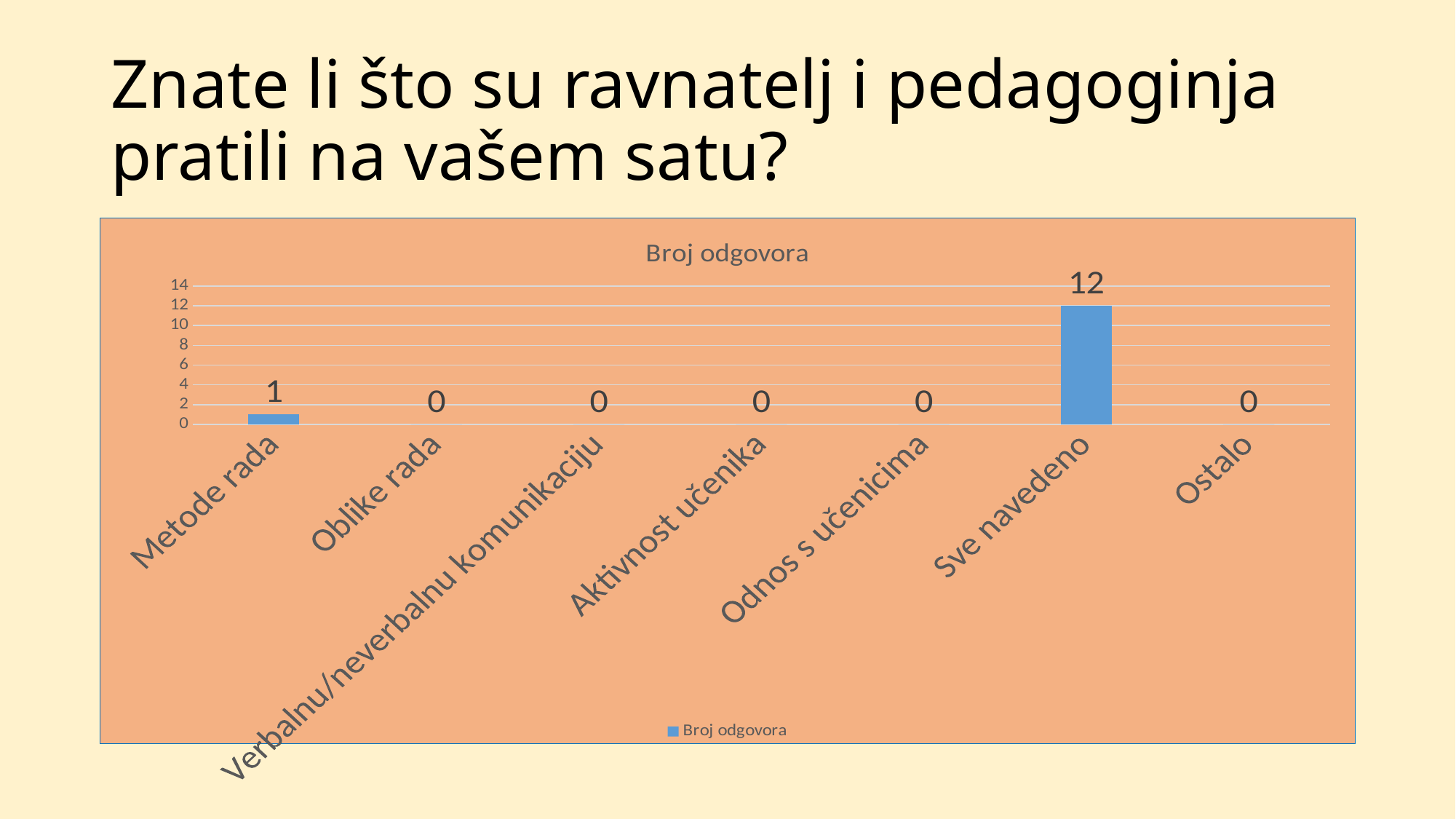
What is the value for 'Metode rada'? 1 Which is larger, the value for 'Metode rada' or the value for 'Aktivnost učenika'? Metode rada What kind of chart is shown? bar chart What is the value for 'Sve navedeno'? 12 What is the value for 'Oblike rada'? 0 Which category has the highest value? Sve navedeno Is the value for 'Sve navedeno' greater or less than 10? greater What is the difference between the values for 'Sve navedeno' and 'Metode rada'? 11 What is the title of the chart? Broj odgovora How many categories are shown on the x axis? 7 What is the value for 'Ostalo'? 0 How many series does the legend list? 1